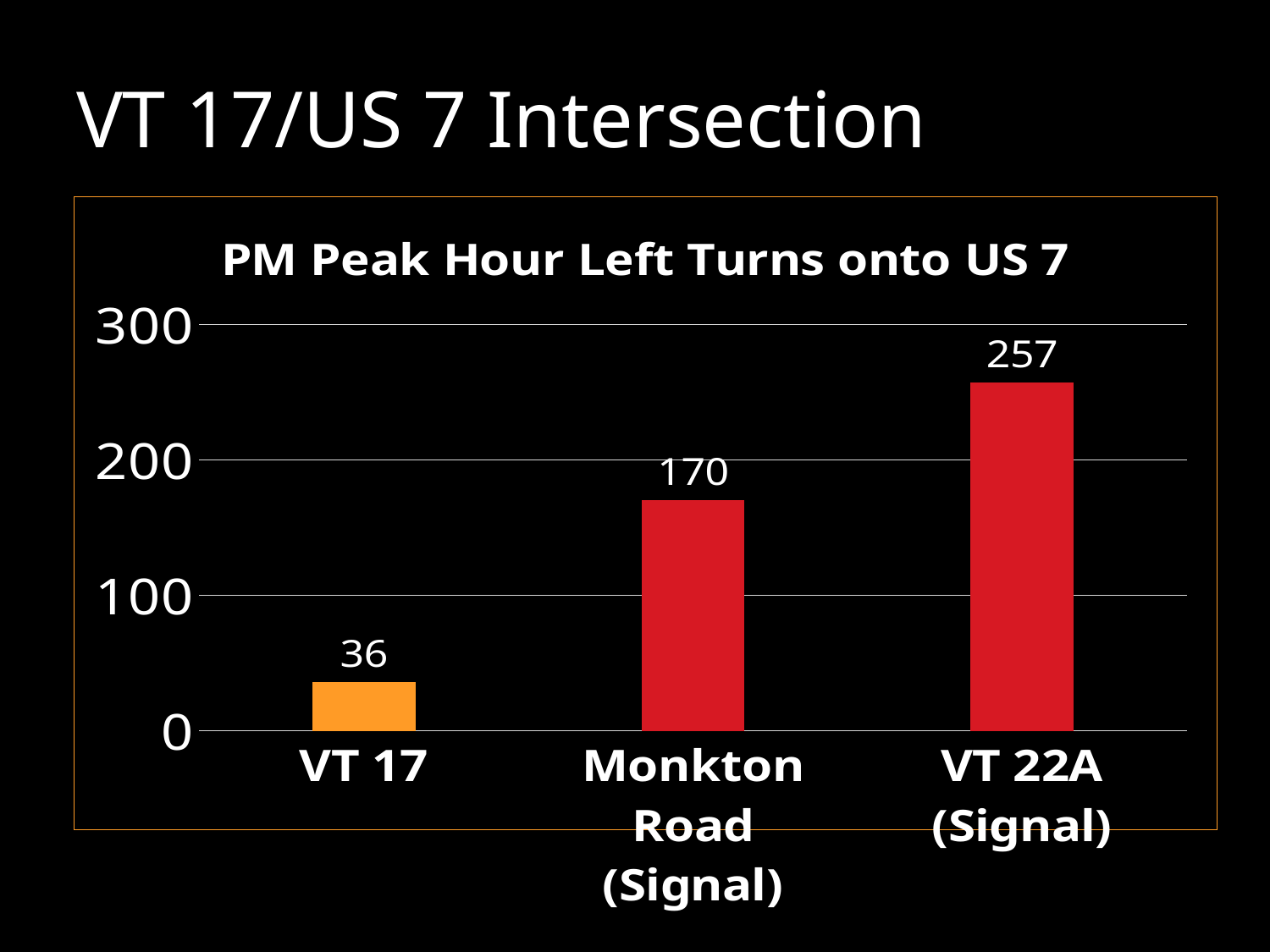
What is the value for VT 22A (Signal)? 257 What is the value for VT 17? 36 What is the difference between the values for VT 22A (Signal) and Monkton Road (Signal)? 87 How many categories are shown in the chart? 3 What is the title of the chart? PM Peak Hour Left Turns onto US 7 What kind of chart is shown on the slide? bar chart What is the value for Monkton Road (Signal)? 170 Which category has the highest value? VT 22A (Signal) Which category has the lowest value? VT 17 Which is larger, the value for VT 17 or the value for Monkton Road (Signal)? Monkton Road (Signal) What is the difference between the values for Monkton Road (Signal) and VT 17? 134 Is the value for VT 22A (Signal) greater or less than 200? greater